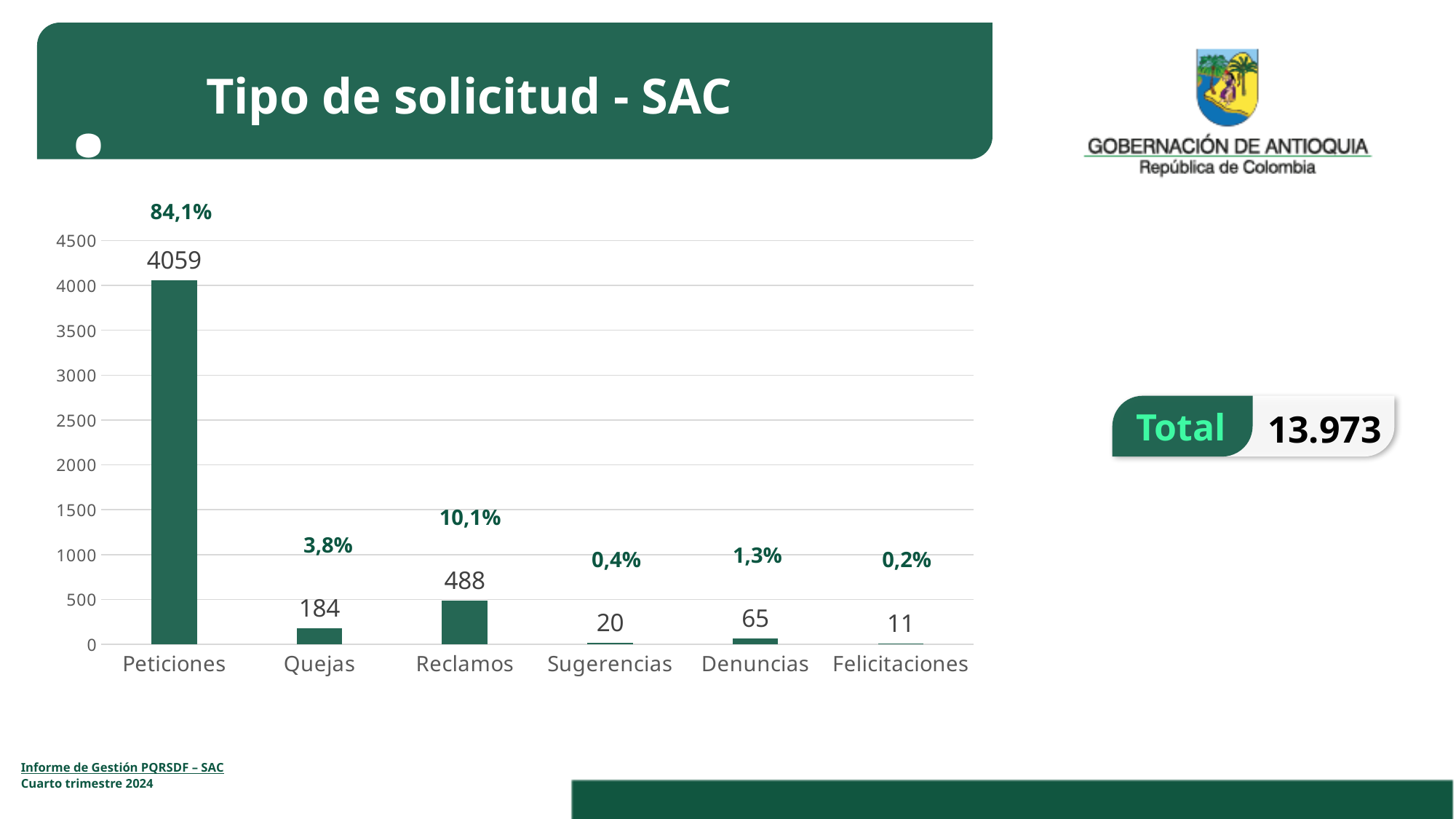
Which category has the lowest value? Felicitaciones Is the value for Peticiones greater or less than 4000? greater What is the value for Peticiones? 4059 What is the value for Denuncias? 65 Which category has the highest value? Peticiones What is the value for Reclamos? 488 What percentage label is shown above the Quejas bar? 3,8% What kind of chart is shown on the slide? Bar chart Which is larger, the value for Denuncias or the value for Sugerencias? Denuncias How many categories are shown on the x axis? 6 What is the title of the chart? Tipo de solicitud - SAC What is the difference between the values for Reclamos and Quejas? 304